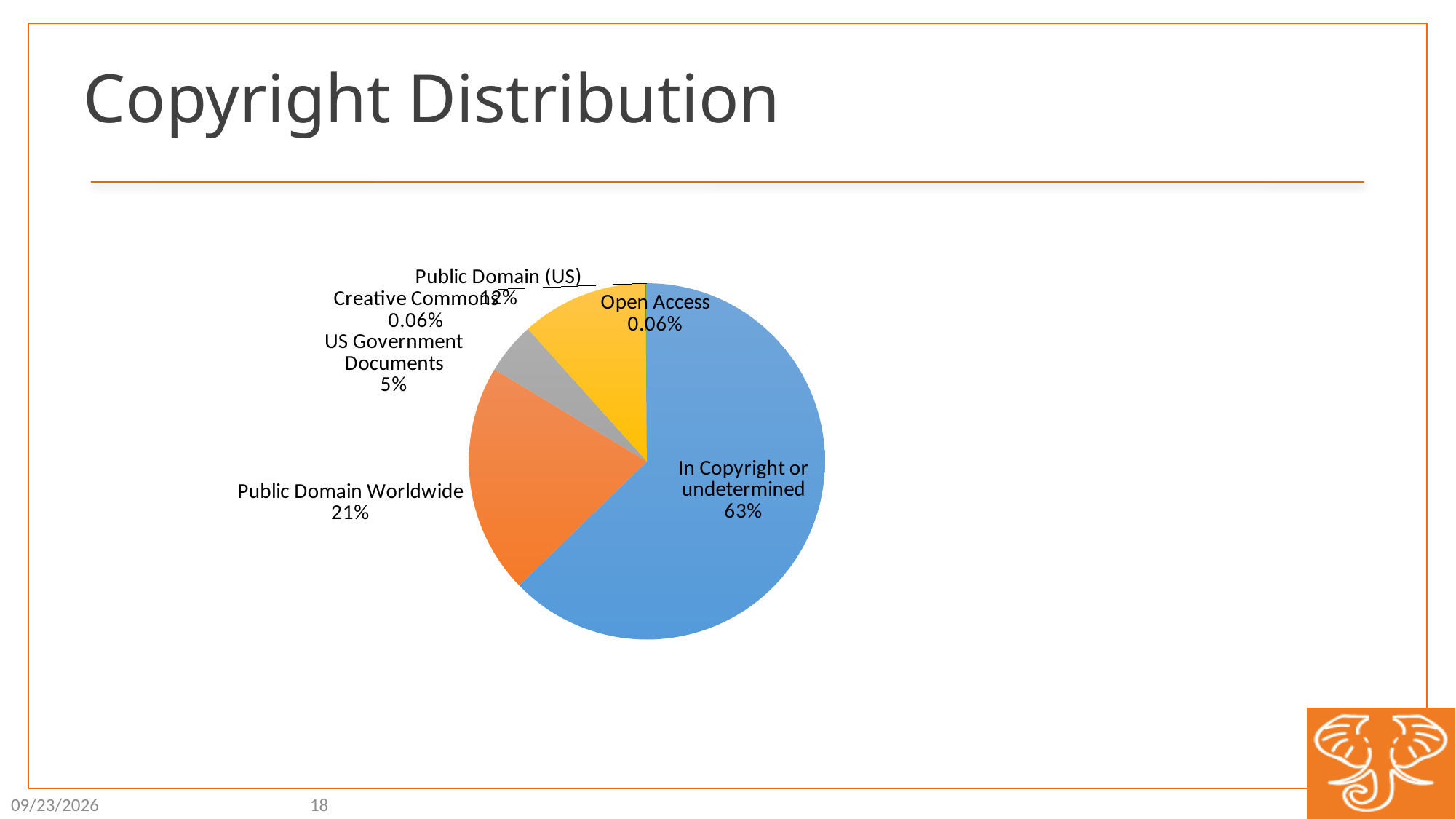
How many slices does the pie chart have? 6 Which is larger, 'Public Domain Worldwide' or 'US Government Documents'? Public Domain Worldwide What is the difference in percentage points between 'In Copyright or undetermined' and 'Public Domain Worldwide'? 42% Which category has the largest slice of the pie? In Copyright or undetermined What share of the pie is 'Creative Commons'? 0.06% What kind of chart is shown on the slide? pie chart What share of the pie is 'In Copyright or undetermined'? 63% What is the title of the slide containing the pie chart? Copyright Distribution What colour is the 'In Copyright or undetermined' slice? blue What share of the pie is 'Open Access'? 0.06%